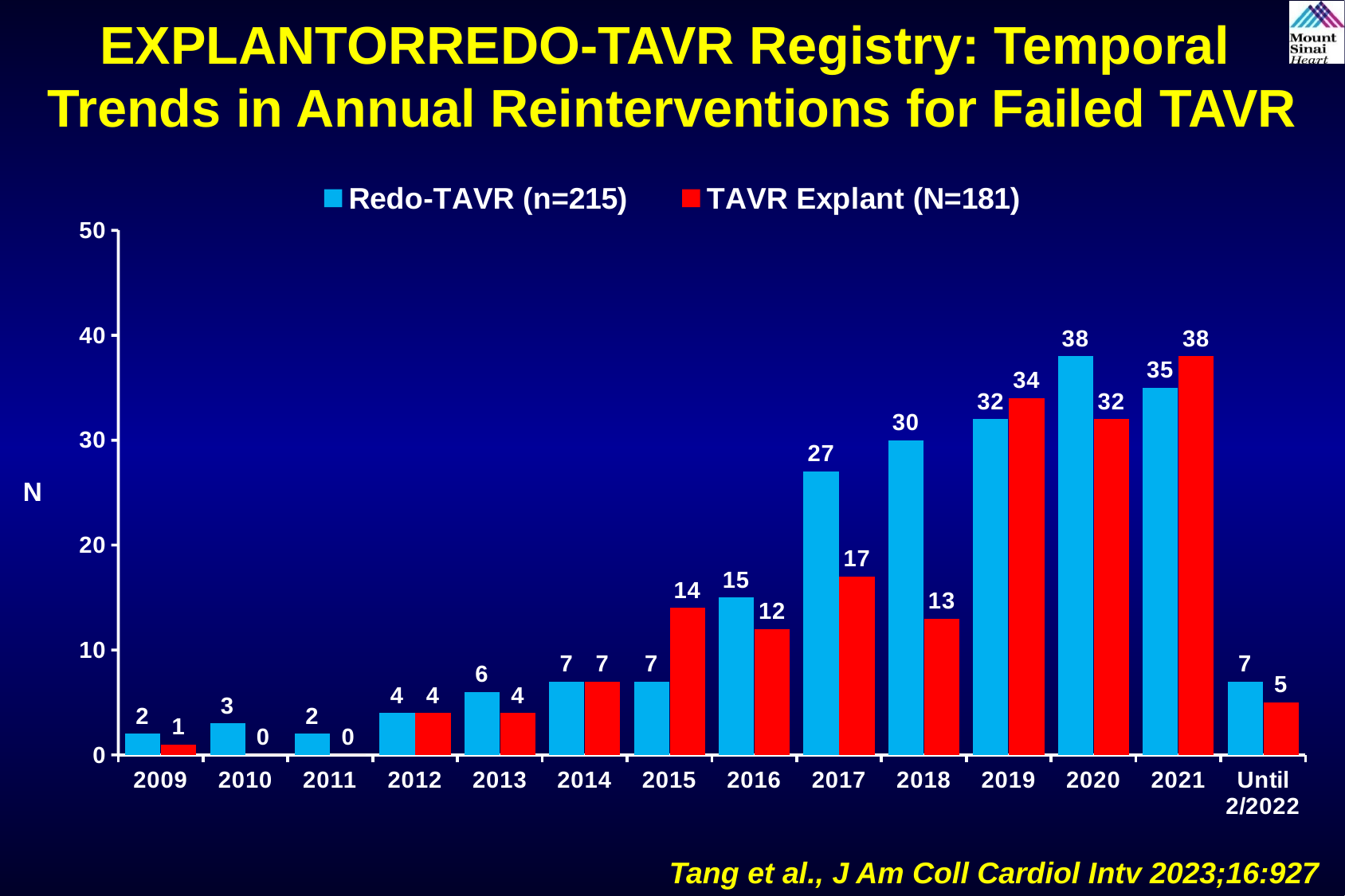
How many time periods are shown on the x axis? 14 What is the TAVR Explant value for 2011? 0 Which is larger in 2016, Redo-TAVR or TAVR Explant? Redo-TAVR What is the TAVR Explant value for 2018? 13 What is the Redo-TAVR value for 2017? 27 What is the difference between the Redo-TAVR and TAVR Explant values in 2018? 17 What kind of chart is shown? Bar chart In which year is the TAVR Explant value highest? 2021 How many series does the legend list? 2 Which colour represents TAVR Explant in the chart? Red Which is larger in 2019, Redo-TAVR or TAVR Explant? TAVR Explant In which year is the Redo-TAVR value highest? 2020